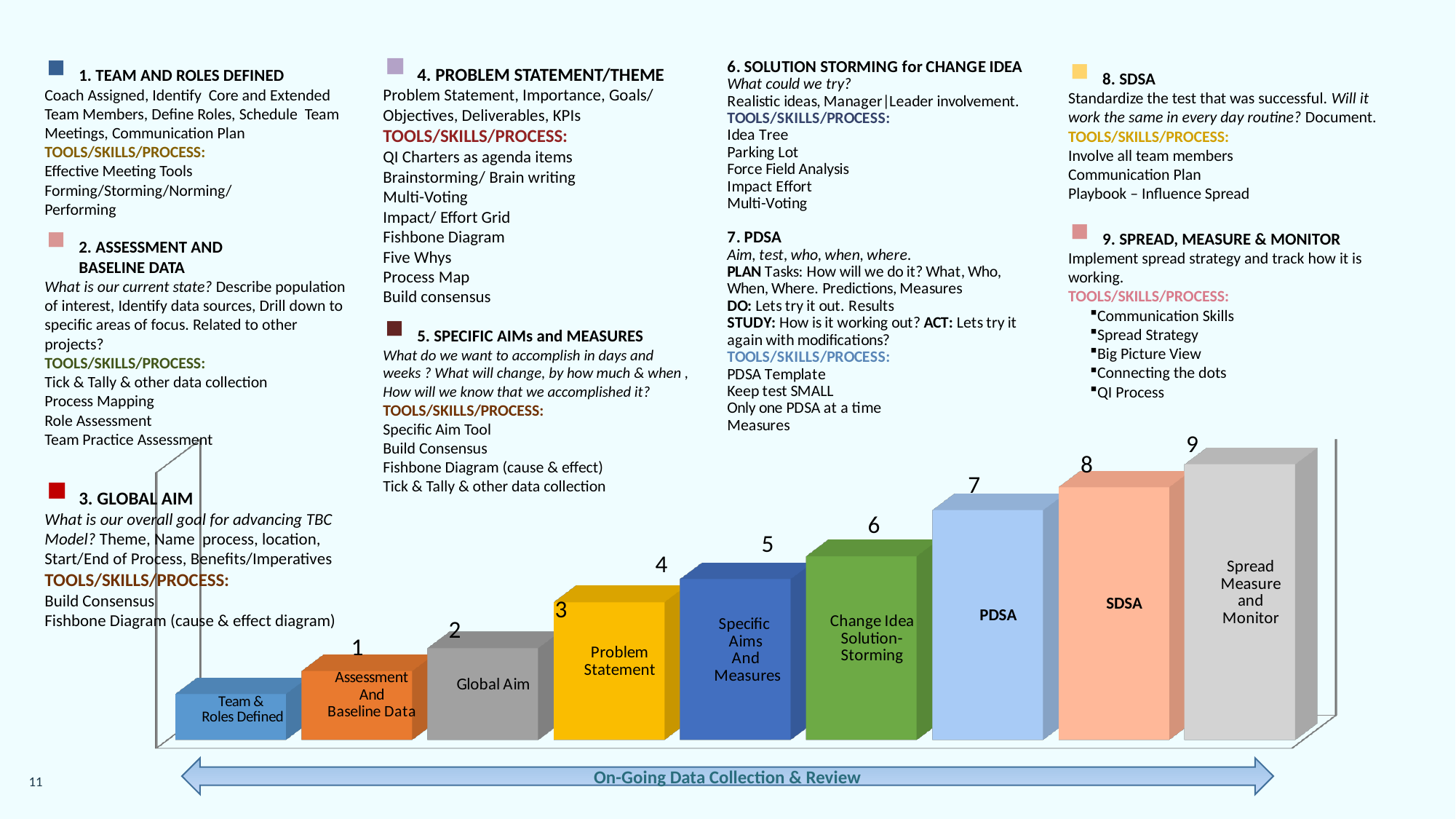
Do the bar values rise or fall from left to right across the chart? rise What kind of chart is shown at the bottom of the slide? bar chart What value is labelled above the PDSA bar? 7 What value is labelled above the Global Aim bar? 2 What value is labelled above the Change Idea Solution-Storming bar? 6 How many bars does the chart contain? 9 Which bar has the lowest value? Team & Roles Defined What text is written on the double-headed arrow beneath the bars? On-Going Data Collection & Review What is the difference between the values labelled for SDSA and Problem Statement? 4 Which bar is taller, Specific Aims And Measures or Assessment And Baseline Data? Specific Aims And Measures Which bar has the highest value? Spread Measure and Monitor What is the label of the bar with value 4? Problem Statement